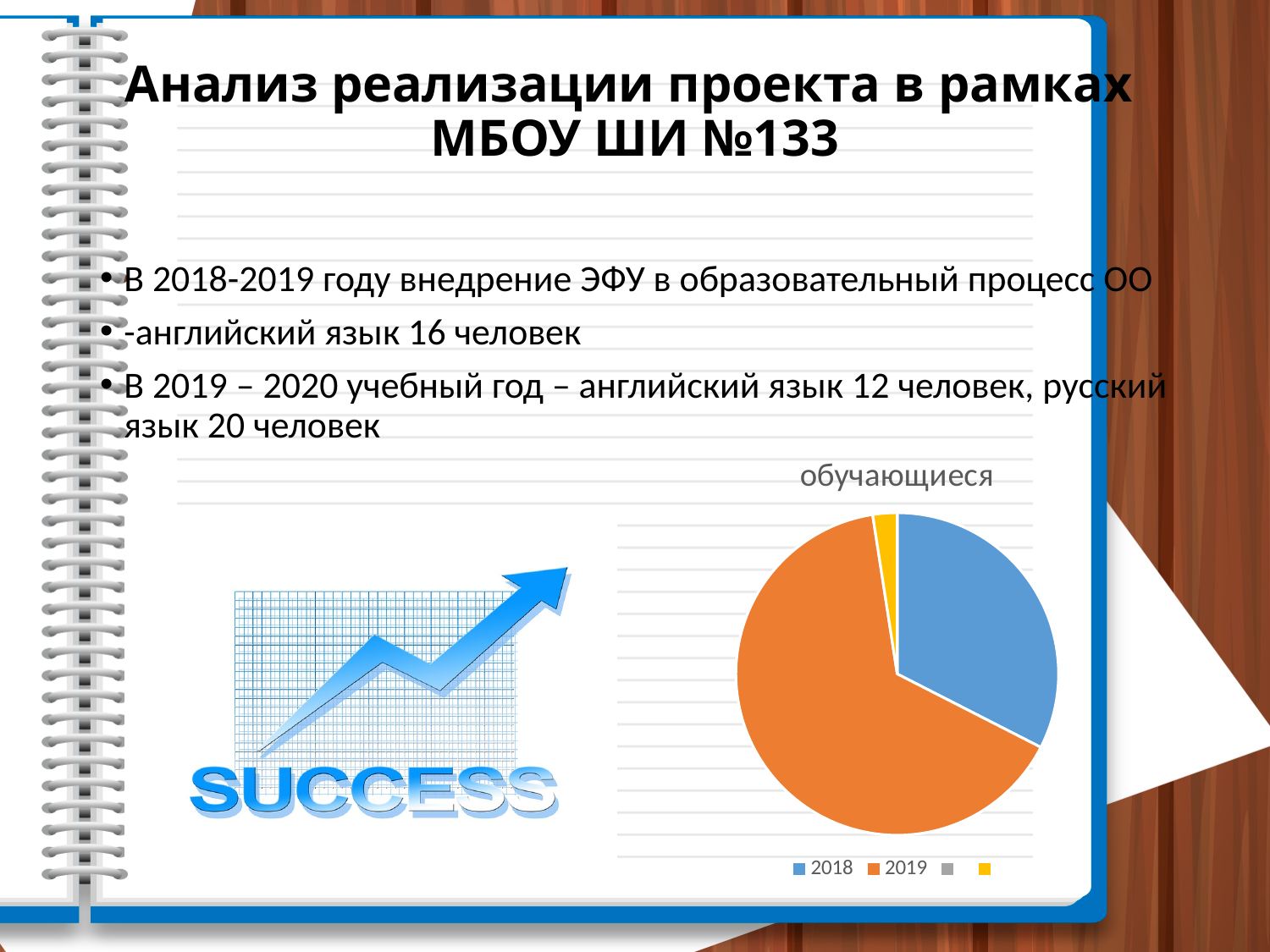
Does the 2018 slice take up more or less than half of the pie chart? less Which slice is larger in the pie chart, 2018 or 2019? 2019 Does the 2019 slice take up more or less than half of the pie chart? more What kind of chart is shown on the slide? pie chart What is the title of the pie chart? обучающиеся Which year has the largest slice in the pie chart? 2019 What colour is the 2019 slice in the pie chart? orange